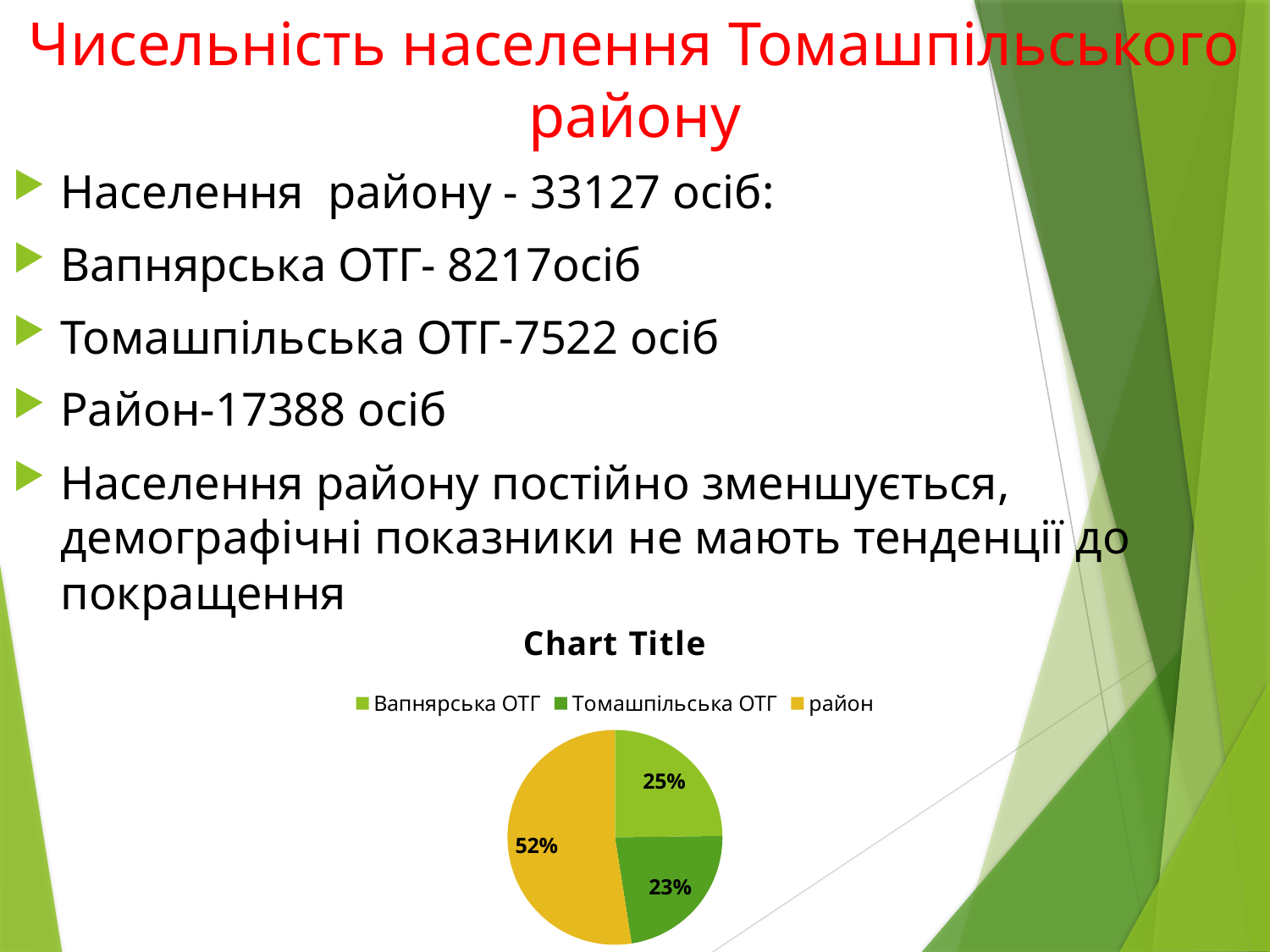
What colour is the район slice in the pie chart? yellow What is the title of the chart? Chart Title Which slice of the pie chart is the smallest? Томашпільська ОТГ Which is larger, the Вапнярська ОТГ slice or the Томашпільська ОТГ slice? Вапнярська ОТГ How many slices does the pie chart have? 3 What share of the pie does the Томашпільська ОТГ slice represent? 23% What share of the pie does the Вапнярська ОТГ slice represent? 25% Which slice of the pie chart is the largest? район What kind of chart is shown on the slide? pie chart What is the difference in percentage points between the район slice and the Вапнярська ОТГ slice? 27 What share of the pie does the район slice represent? 52% How many entries does the chart legend list? 3